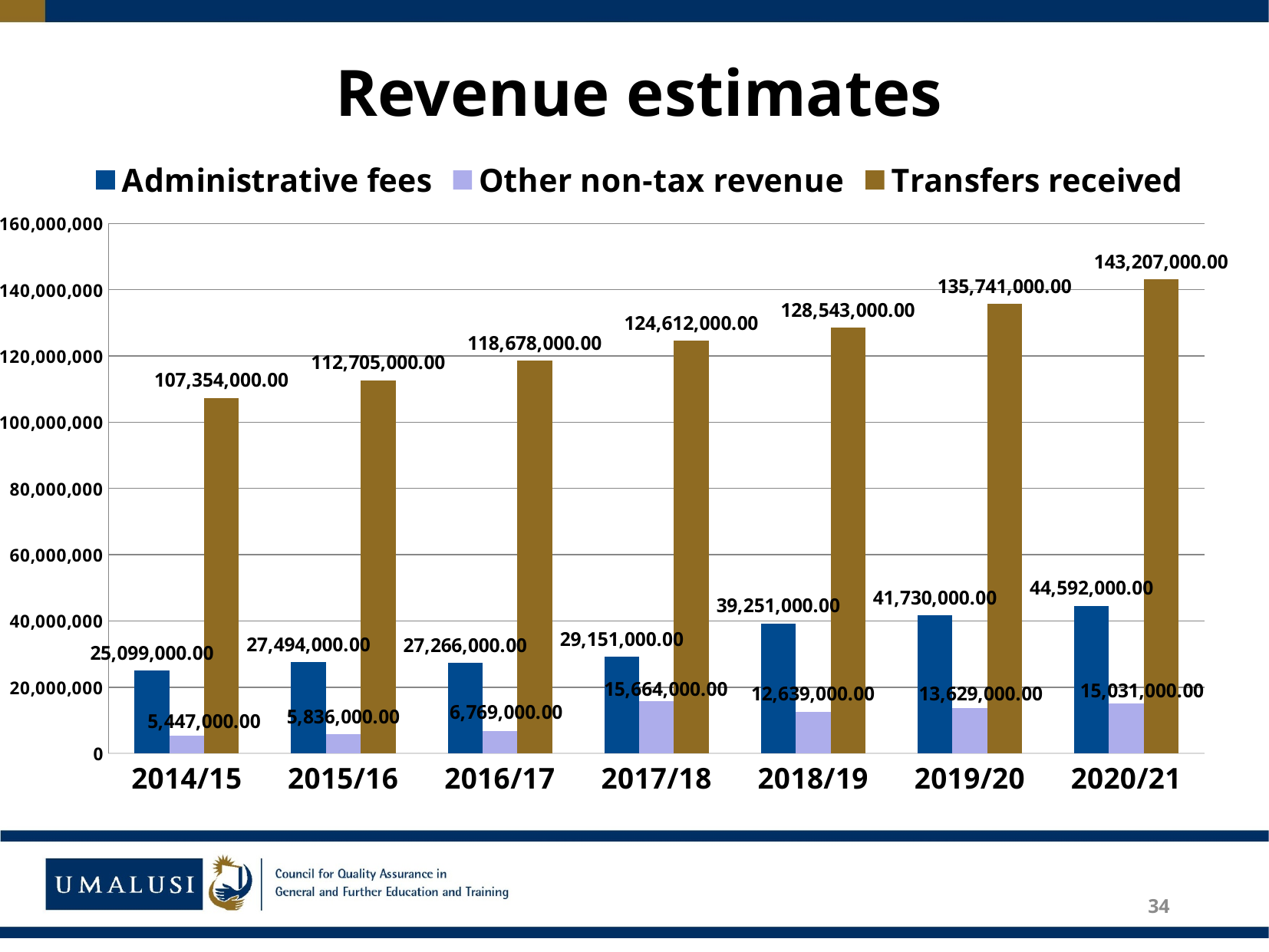
What is the value of Administrative fees for 2018/19? 39,251,000.00 What kind of chart is shown on the slide? bar chart In which year is Other non-tax revenue lowest? 2014/15 Which is larger: Administrative fees in 2017/18 or Administrative fees in 2019/20? 2019/20 Is the value of Transfers received for 2017/18 greater or less than 120,000,000? greater In which year is Administrative fees highest? 2020/21 What is the value of Other non-tax revenue for 2016/17? 6,769,000.00 What is the difference between Transfers received in 2020/21 and in 2014/15? 35,853,000.00 How many series does the legend list? 3 What is the value of Transfers received for 2020/21? 143,207,000.00 How many years are shown on the x axis? 7 Do the values for Transfers received rise or fall from 2014/15 to 2020/21? rise